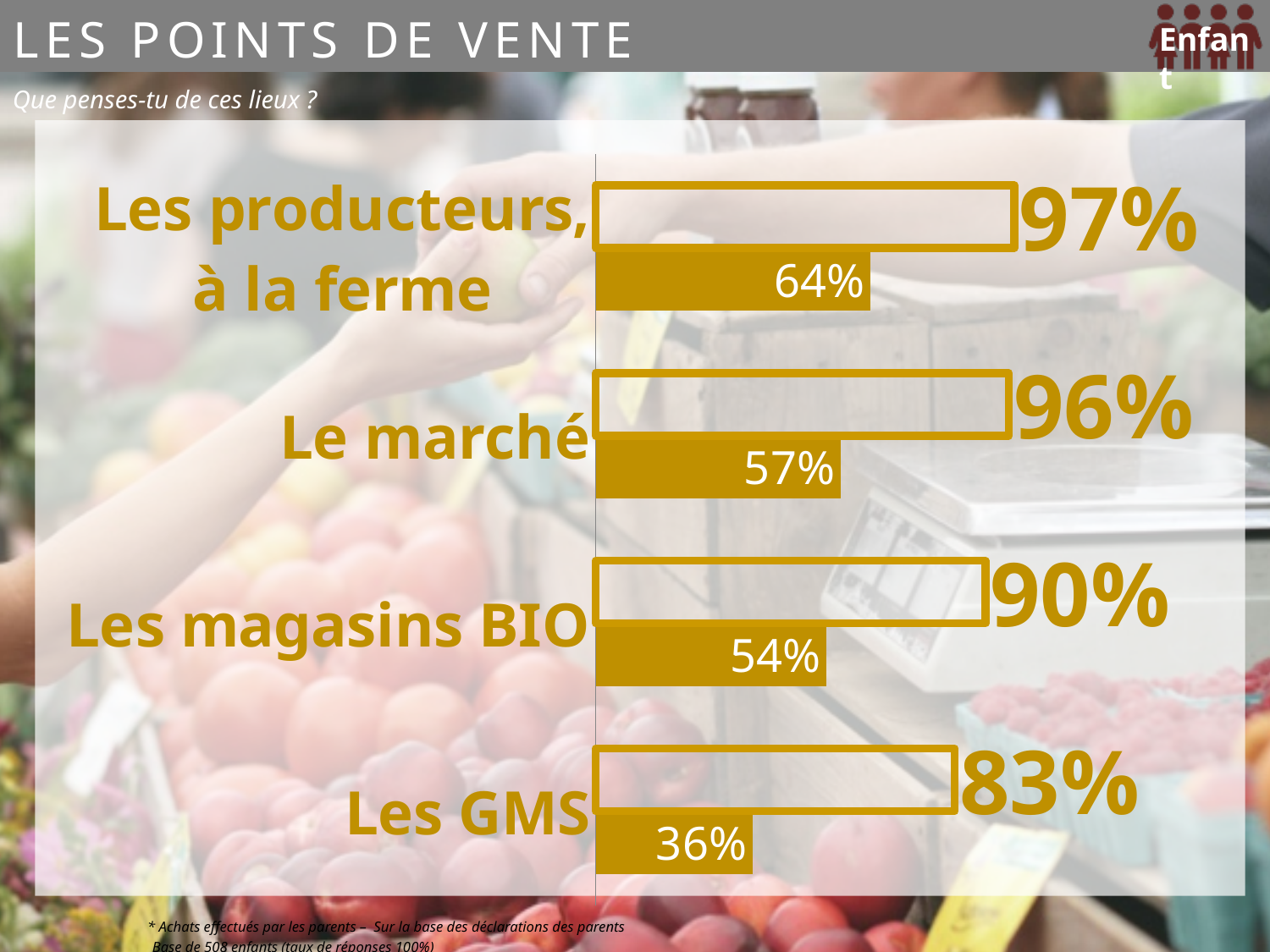
What is the value shown on the filled bar for "Le marché"? 57% What is the value shown on the outlined bar for "Les producteurs, à la ferme"? 97% What is the value shown on the filled bar for "Les GMS"? 36% What is the title of the slide containing the chart? LES POINTS DE VENTE How many categories are shown in the chart? 4 What is the value shown on the outlined bar for "Les magasins BIO"? 90% Which category has the highest value on the filled bars? Les producteurs, à la ferme What is the difference between the filled bar values for "Les producteurs, à la ferme" and "Les magasins BIO"? 10% What kind of chart is shown on the slide? Bar chart Which is larger: the filled bar for "Le marché" or the filled bar for "Les GMS"? Le marché What is the difference between the outlined bar and the filled bar for "Les GMS"? 47% Which category has the lowest value on the outlined bars? Les GMS